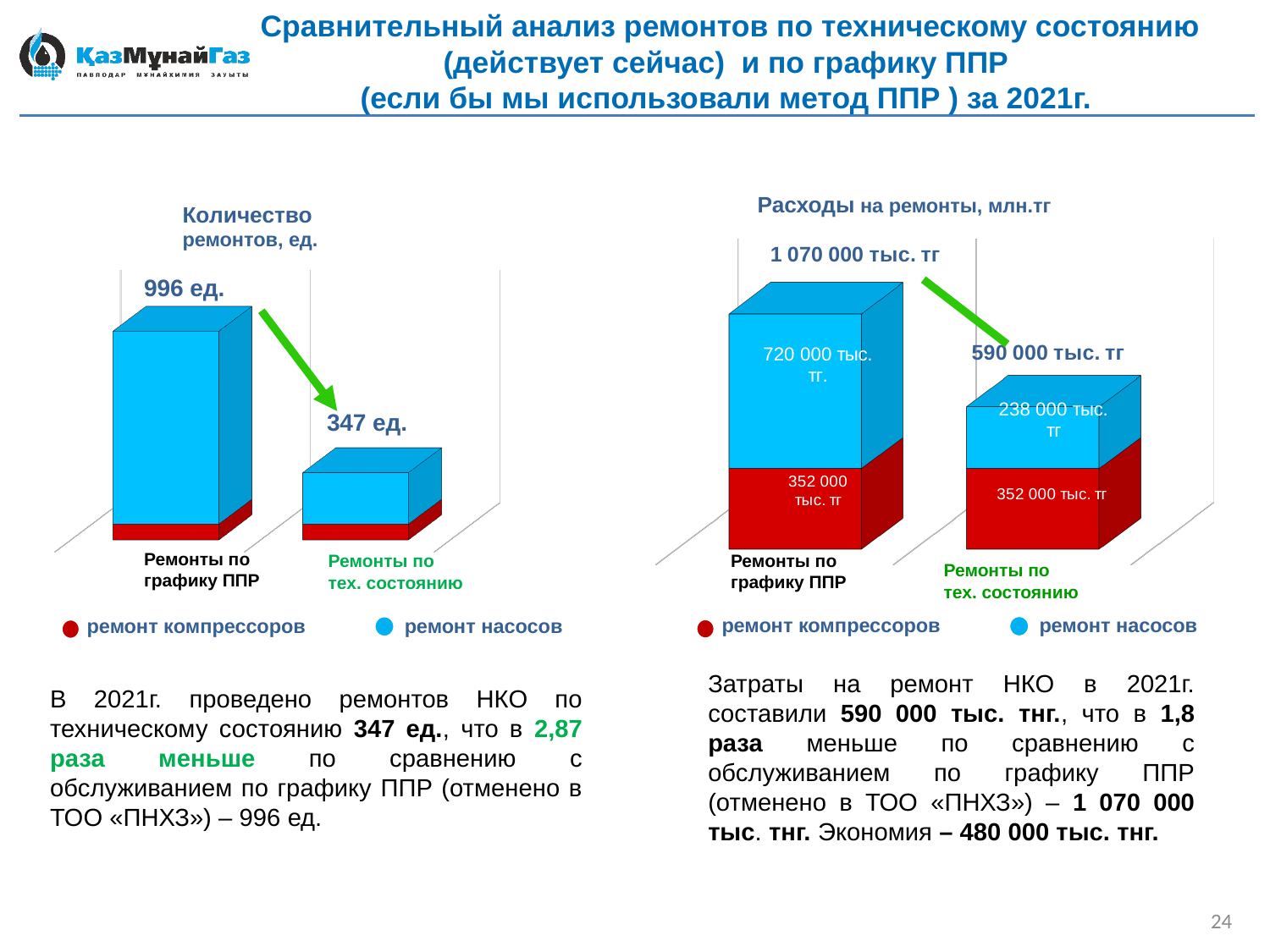
In the chart 'Количество ремонтов, ед.', which category has the higher value? Ремонты по графику ППР In the chart 'Расходы на ремонты, млн.тг', what is the total for 'Ремонты по графику ППР'? 1 070 000 тыс. тг In the chart 'Количество ремонтов, ед.', what is the value for 'Ремонты по тех. состоянию'? 347 ед. In the chart 'Расходы на ремонты, млн.тг', what is the value of 'ремонт насосов' for 'Ремонты по тех. состоянию'? 238 000 тыс. тг What kind of chart is 'Расходы на ремонты, млн.тг'? Bar chart How many categories are shown in the chart 'Количество ремонтов, ед.'? 2 In the chart 'Расходы на ремонты, млн.тг', for 'Ремонты по графику ППР', which is larger: 'ремонт компрессоров' or 'ремонт насосов'? ремонт насосов How many series does the legend of the chart 'Расходы на ремонты, млн.тг' list? 2 In the chart 'Расходы на ремонты, млн.тг', what is the difference between the totals for 'Ремонты по графику ППР' and 'Ремонты по тех. состоянию'? 480 000 тыс. тг In the chart 'Количество ремонтов, ед.', what is the value for 'Ремонты по графику ППР'? 996 ед. In the chart 'Количество ремонтов, ед.', what is the difference between 'Ремонты по графику ППР' and 'Ремонты по тех. состоянию'? 649 ед. In the chart 'Расходы на ремонты, млн.тг', what is the value of 'ремонт насосов' for 'Ремонты по графику ППР'? 720 000 тыс. тг